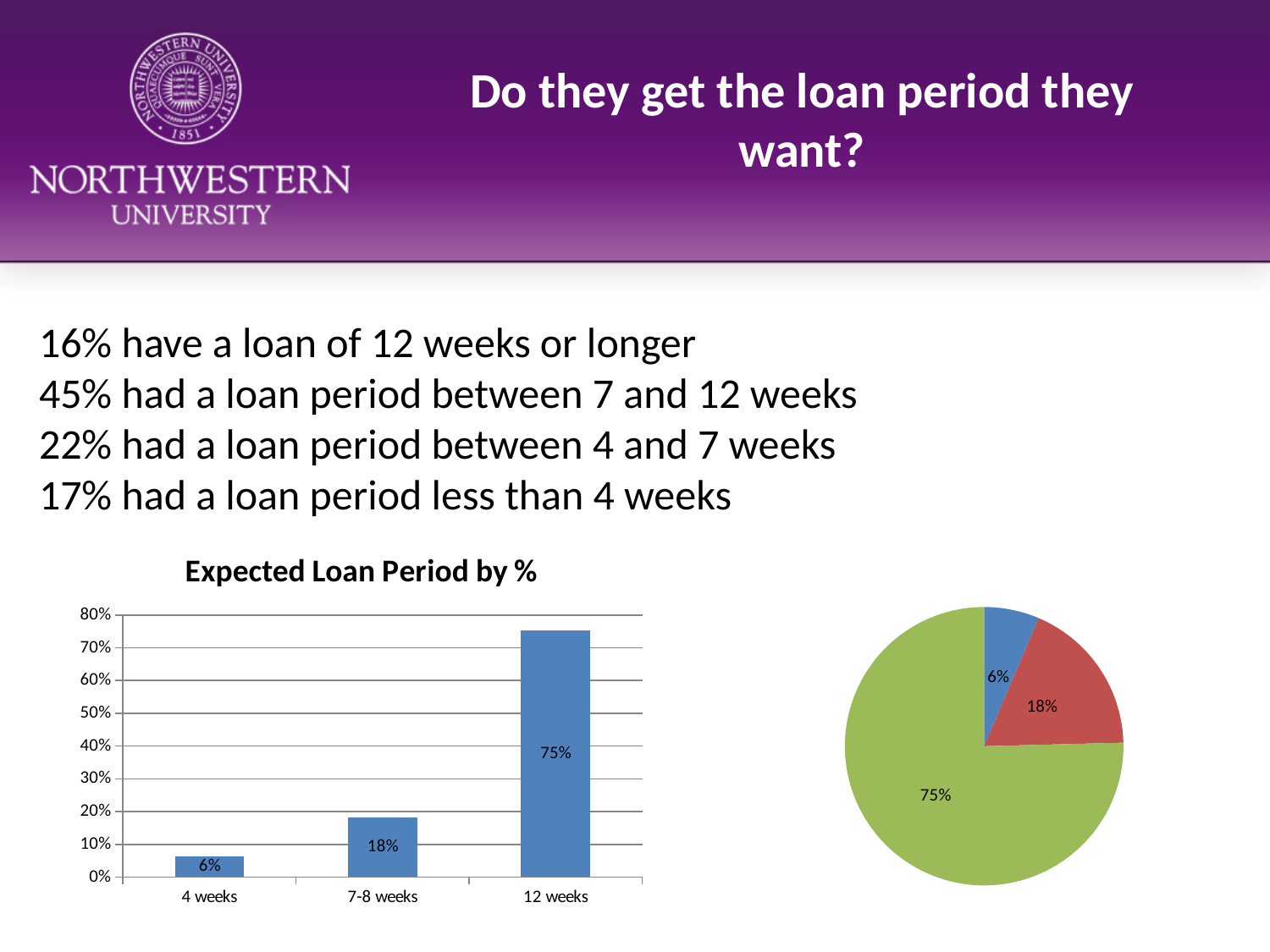
In the 'Expected Loan Period by %' chart, which is larger, the value for 7-8 weeks or the value for 4 weeks? 7-8 weeks In the 'Expected Loan Period by %' chart, which category has the lowest value? 4 weeks What kind of chart is the 'Expected Loan Period by %' chart? Bar chart In the 'Expected Loan Period by %' chart, what is the value for 4 weeks? 6% In the 'Expected Loan Period by %' chart, what is the value for 12 weeks? 75% In the 'Expected Loan Period by %' chart, do the values rise or fall from left to right along the x axis? Rise In the 'Expected Loan Period by %' chart, which category has the highest value? 12 weeks How many categories are shown on the x axis of the 'Expected Loan Period by %' chart? 3 How many slices does the pie chart on the right of the slide have? 3 In the pie chart on the right of the slide, what share does the green slice represent? 75% In the 'Expected Loan Period by %' chart, what is the difference between the values for 12 weeks and 7-8 weeks? 57% In the 'Expected Loan Period by %' chart, what is the value for 7-8 weeks? 18%